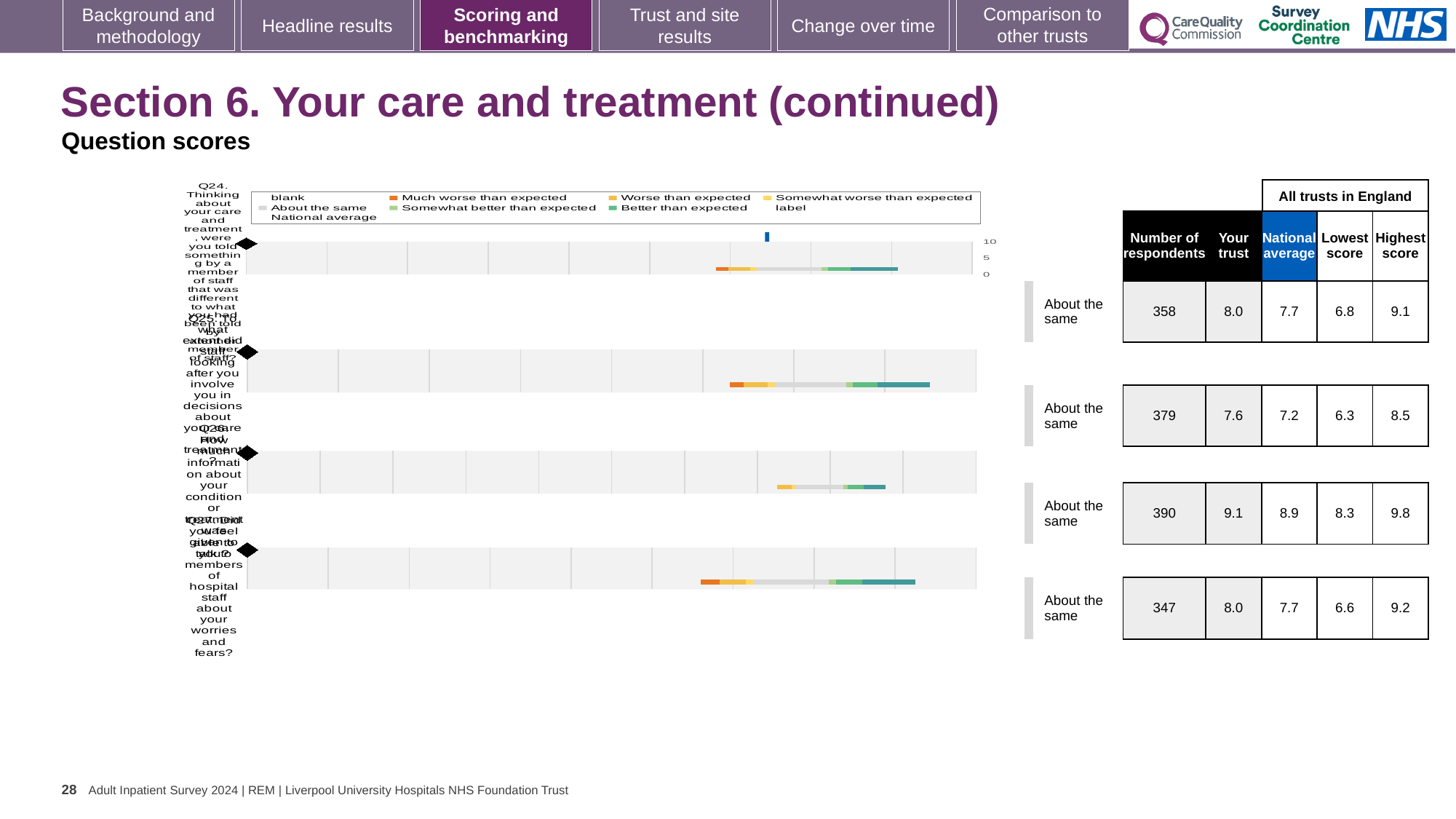
What kind of chart is shown on the slide? Bar chart How many questions are plotted on the chart? 4 Which question has the highest 'Your trust' score? Q26 What is the 'Your trust' score for Q26? 9.1 What is the difference between the 'Your trust' score and the national average for Q26? 0.2 What is the difference between the highest score and the lowest score for Q26? 1.5 What is the highest score among all trusts in England for Q25? 8.5 For Q24, which is larger: the 'Your trust' score or the national average? Your trust (8.0) What benchmark category is shown for Q27? About the same Which question has the lowest number of respondents? Q27 What is the title of the slide? Section 6. Your care and treatment (continued) How many respondents answered Q25? 379